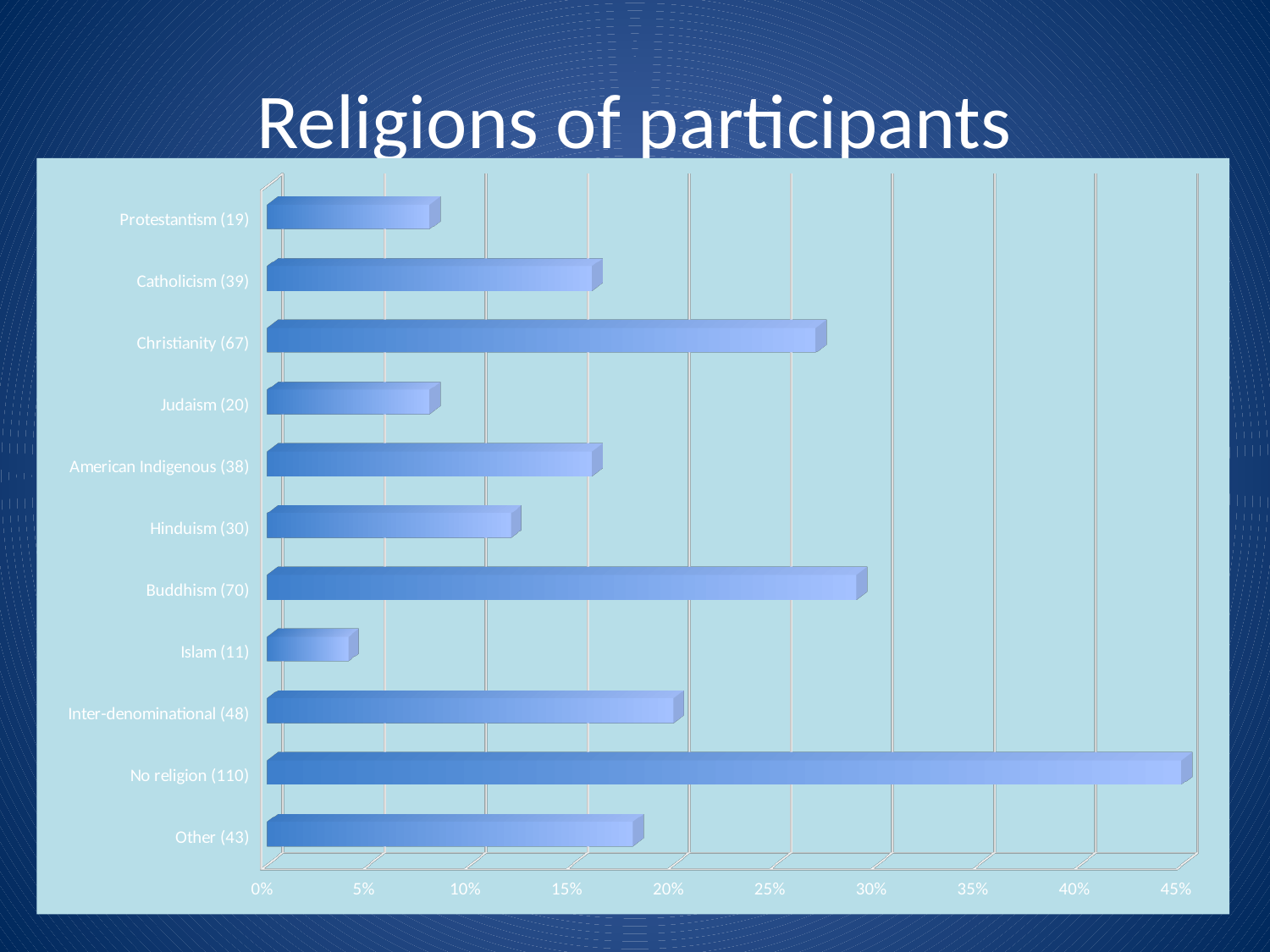
Which has the larger value, Inter-denominational or Judaism? Inter-denominational Is the value for Islam greater or less than 5%? less Is the value for Other greater or less than 20%? less How many religion categories are plotted in the chart? 11 Is the value for Hinduism greater or less than 10%? greater Which has the larger value, Christianity or Catholicism? Christianity Which category has the longest bar? No religion (110) What participant count is shown in the category label for Buddhism? 70 What is the title of the chart? Religions of participants Which category has the shortest bar? Islam (11) What kind of chart is shown on the slide? bar chart